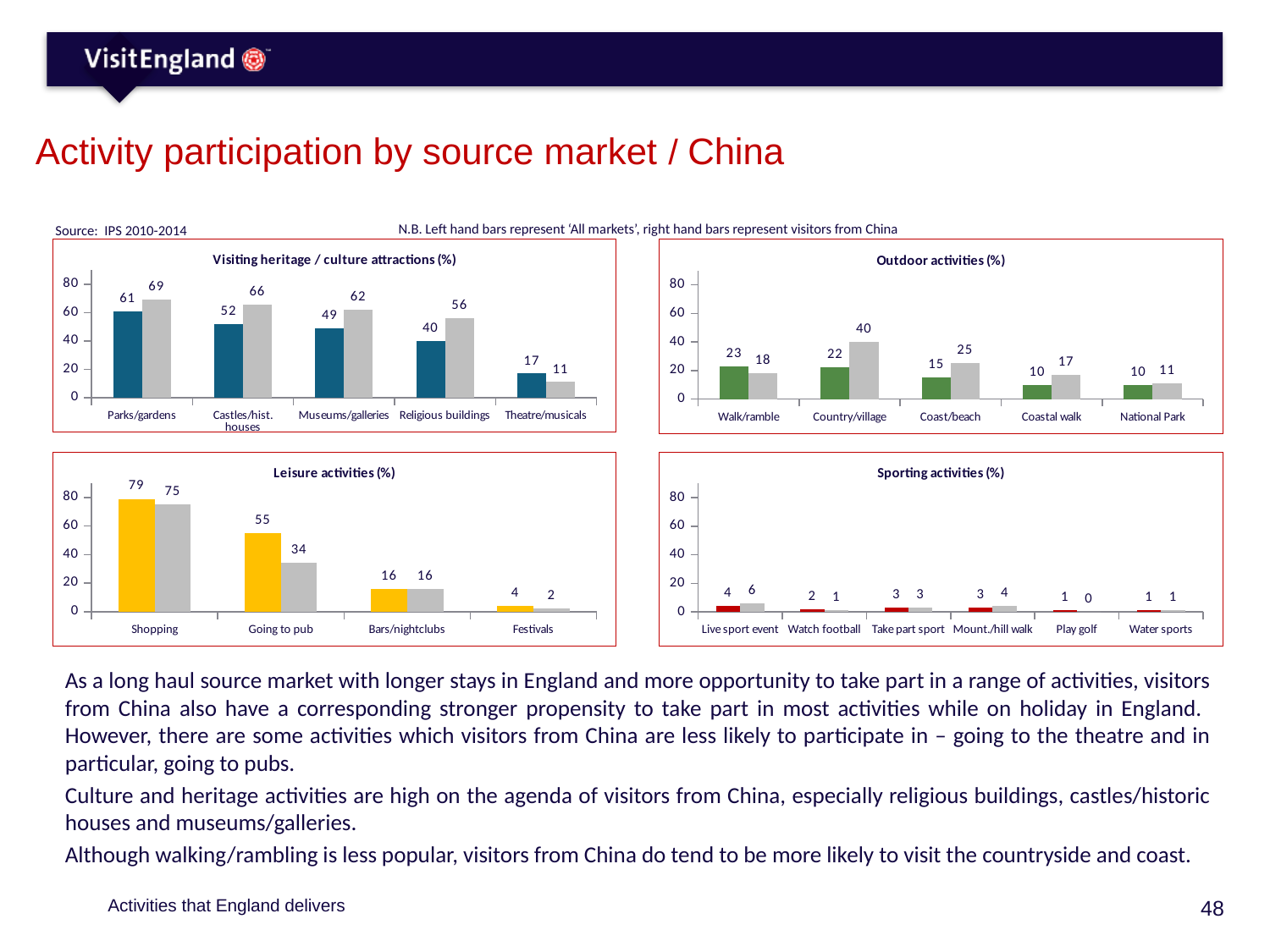
In the 'Leisure activities (%)' chart, what is the 'All markets' value for Going to pub? 55 In the 'Visiting heritage / culture attractions (%)' chart, what is the value for visitors from China (right hand bar) for Religious buildings? 56 In the 'Outdoor activities (%)' chart, what is the value for visitors from China for Country/village? 40 In the 'Sporting activities (%)' chart, what is the value for visitors from China for Live sport event? 6 In the 'Outdoor activities (%)' chart, what is the difference between the China value and the 'All markets' value for Coast/beach? 10 How many categories are shown on the x axis of the 'Leisure activities (%)' chart? 4 In the 'Leisure activities (%)' chart, which category has the highest value for visitors from China? Shopping In the 'Outdoor activities (%)' chart, which is larger for Walk/ramble: the 'All markets' value or the China value? All markets How many categories are shown on the x axis of the 'Sporting activities (%)' chart? 6 In the 'Visiting heritage / culture attractions (%)' chart, what is the 'All markets' value (left hand bar) for Museums/galleries? 49 What type of chart is the 'Outdoor activities (%)' chart? Bar chart In the 'Visiting heritage / culture attractions (%)' chart, which category has the lowest value for visitors from China? Theatre/musicals